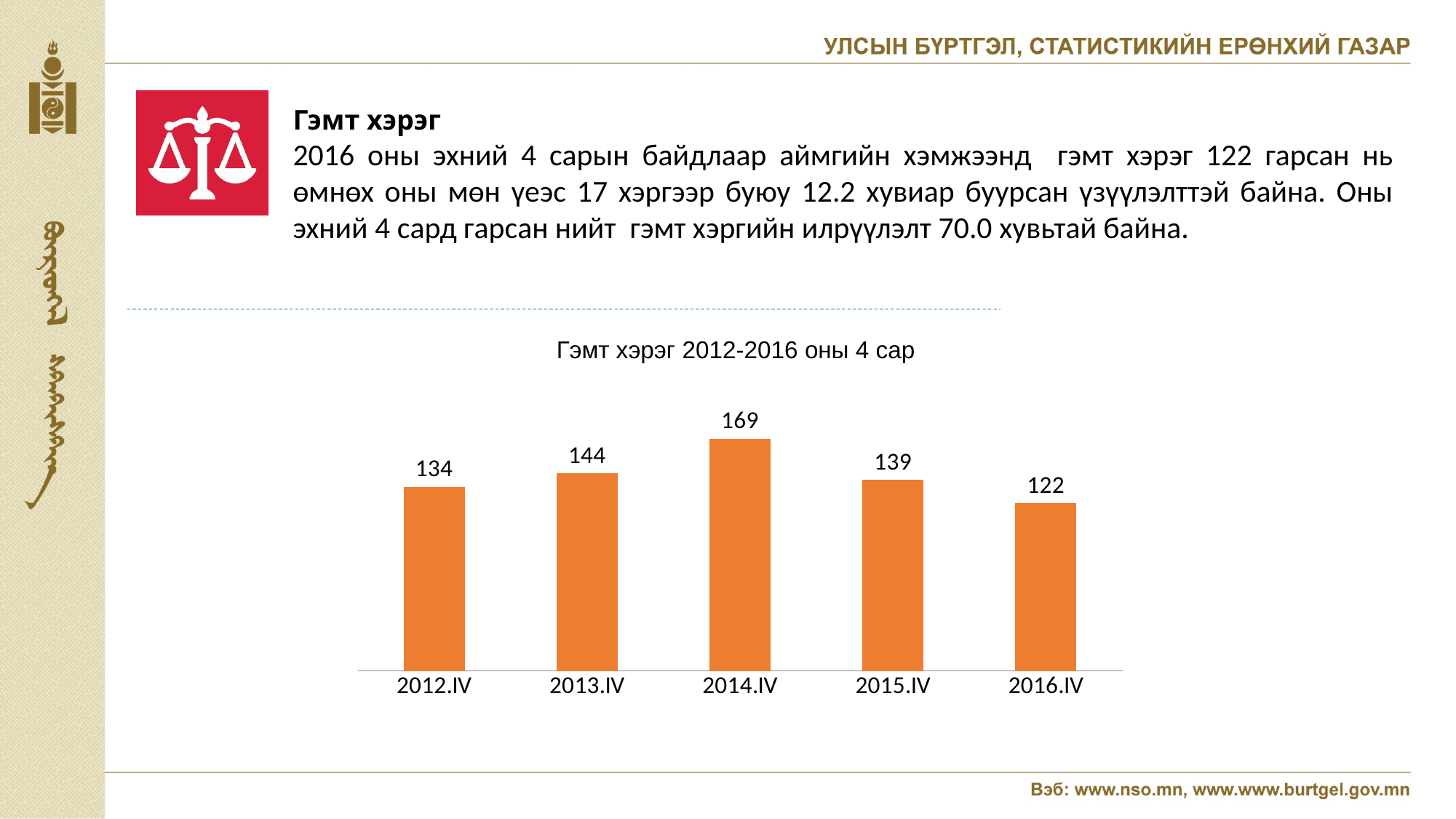
What is the value for 2012.IV? 134 What is the difference between the values for 2013.IV and 2012.IV? 10 What is the value for 2014.IV? 169 What kind of chart is shown on the slide? bar chart What is the difference between the values for 2014.IV and 2016.IV? 47 Which category has the lowest value? 2016.IV What is the value for 2016.IV? 122 Which category has the highest value? 2014.IV Do the values rise or fall from 2014.IV to 2016.IV? fall What is the title of the chart? Гэмт хэрэг 2012-2016 оны 4 сар How many categories are shown on the x axis? 5 Which is larger, the value for 2013.IV or the value for 2015.IV? 2013.IV